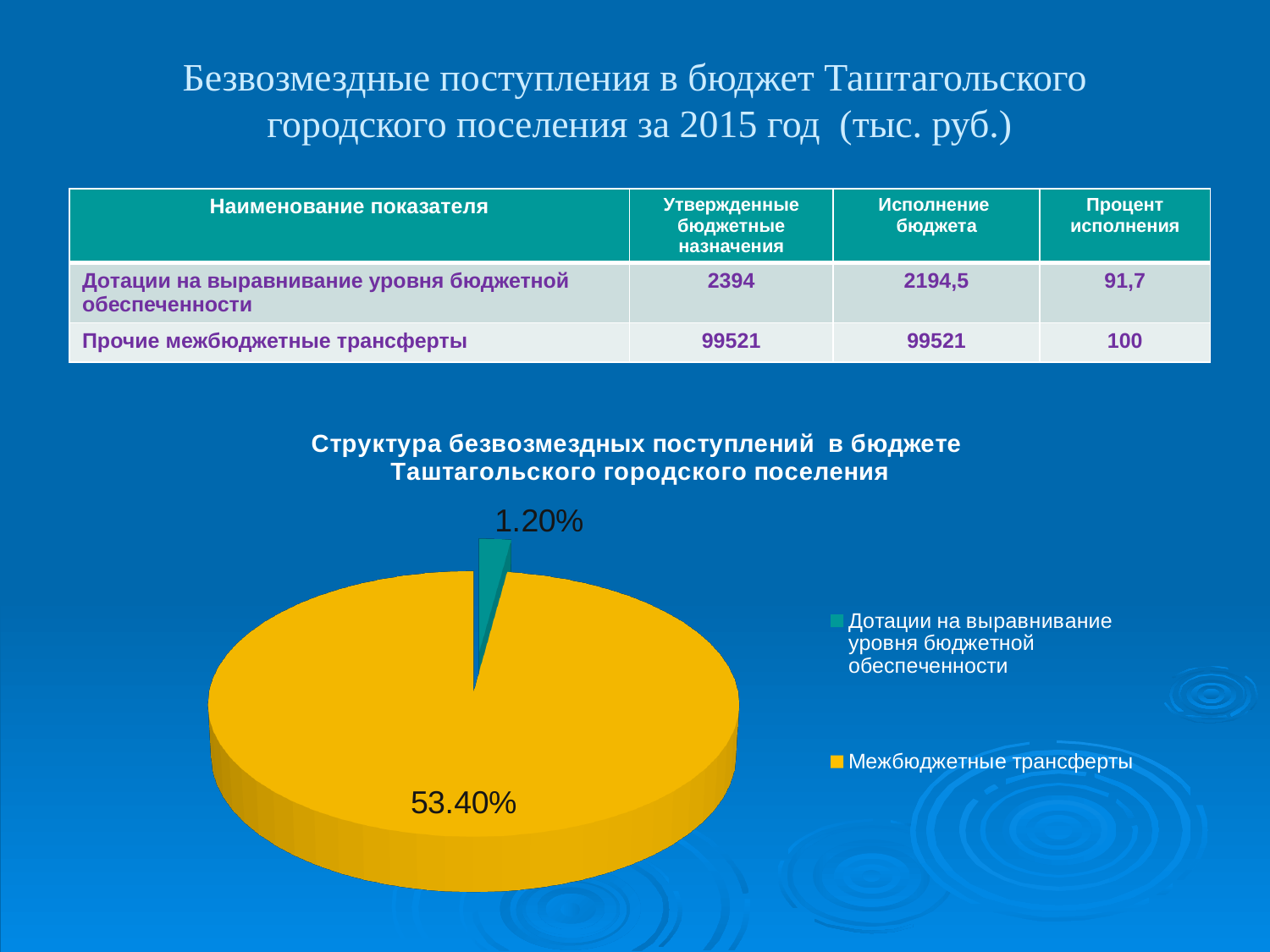
Which is larger in the pie chart: Межбюджетные трансферты or Дотации на выравнивание уровня бюджетной обеспеченности? Межбюджетные трансферты What kind of chart is shown on the slide? pie chart Which category has the smallest slice in the pie chart? Дотации на выравнивание уровня бюджетной обеспеченности What value is labelled on the pie slice for Межбюджетные трансферты? 53.40% What colour is the slice for Межбюджетные трансферты in the pie chart? yellow What value is labelled on the pie slice for Дотации на выравнивание уровня бюджетной обеспеченности? 1.20% What is the difference between the labelled values for Межбюджетные трансферты and Дотации на выравнивание уровня бюджетной обеспеченности in the pie chart? 52.20% Which category has the largest slice in the pie chart? Межбюджетные трансферты How many slices does the pie chart have? 2 What is the title of the pie chart? Структура безвозмездных поступлений в бюджете Таштагольского городского поселения How many entries does the legend of the pie chart list? 2 What share of the pie is labelled for Дотации на выравнивание уровня бюджетной обеспеченности? 1.20%